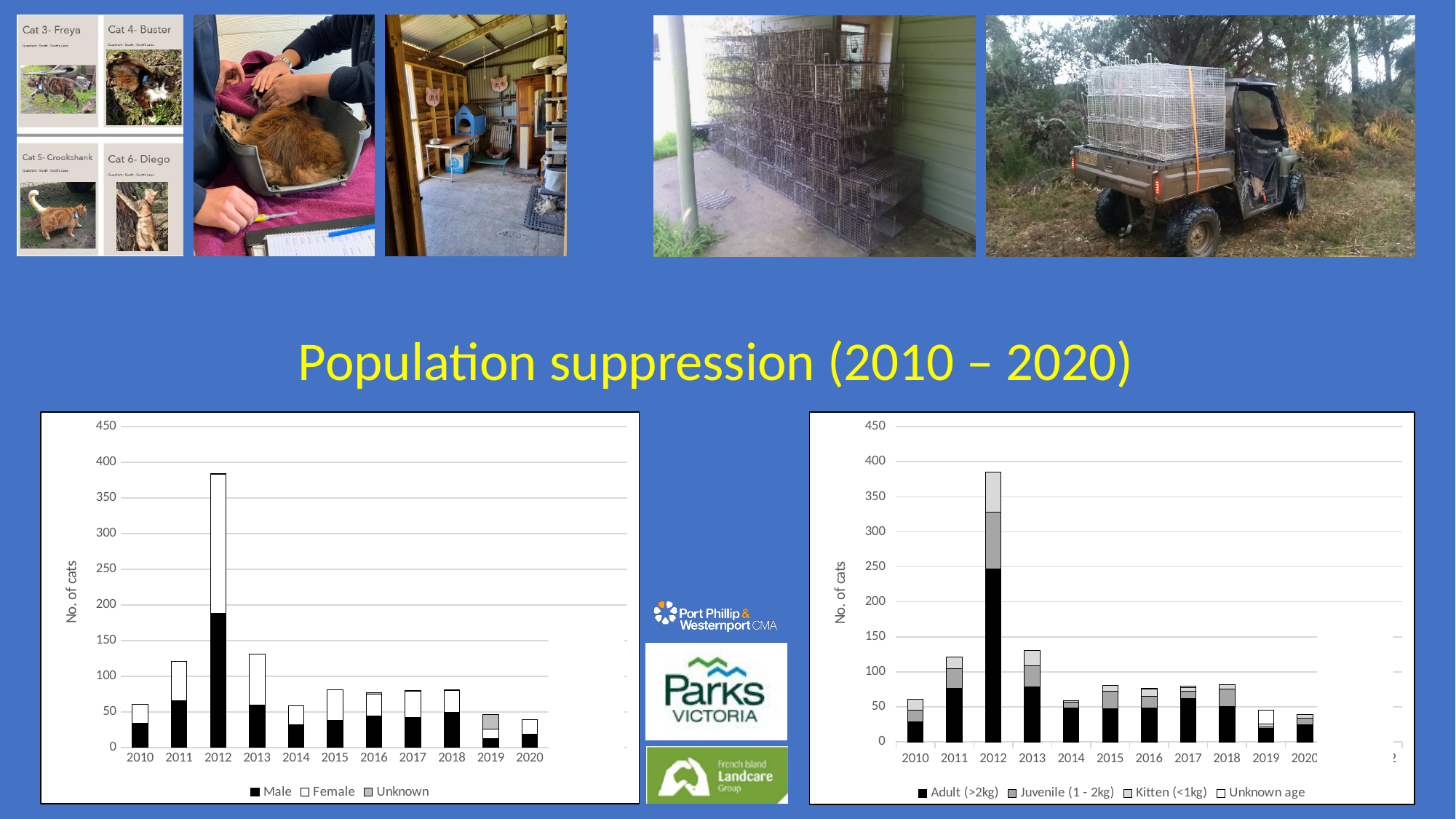
How many series does the legend of the right chart (Adult/Juvenile/Kitten/Unknown age) list? 4 In the right chart, which year has the lowest total number of cats? 2020 In the left chart, is the total number of cats for 2020 greater or less than 50? less In the right chart, from 2012 to 2020, do the total numbers of cats generally rise or fall? fall How many series does the legend of the left chart list? 3 In the right chart, is the Adult (>2kg) value for 2012 greater or less than 200? greater How many years are shown on the x axis of the left chart? 11 In the left chart, which year has the highest total number of cats? 2012 What is the y-axis label of the right chart? No. of cats In the left chart, is the total number of cats for 2012 greater or less than 350? greater What kind of chart is the left chart (Male/Female/Unknown)? bar chart In the left chart, which year has the larger total number of cats, 2011 or 2015? 2011